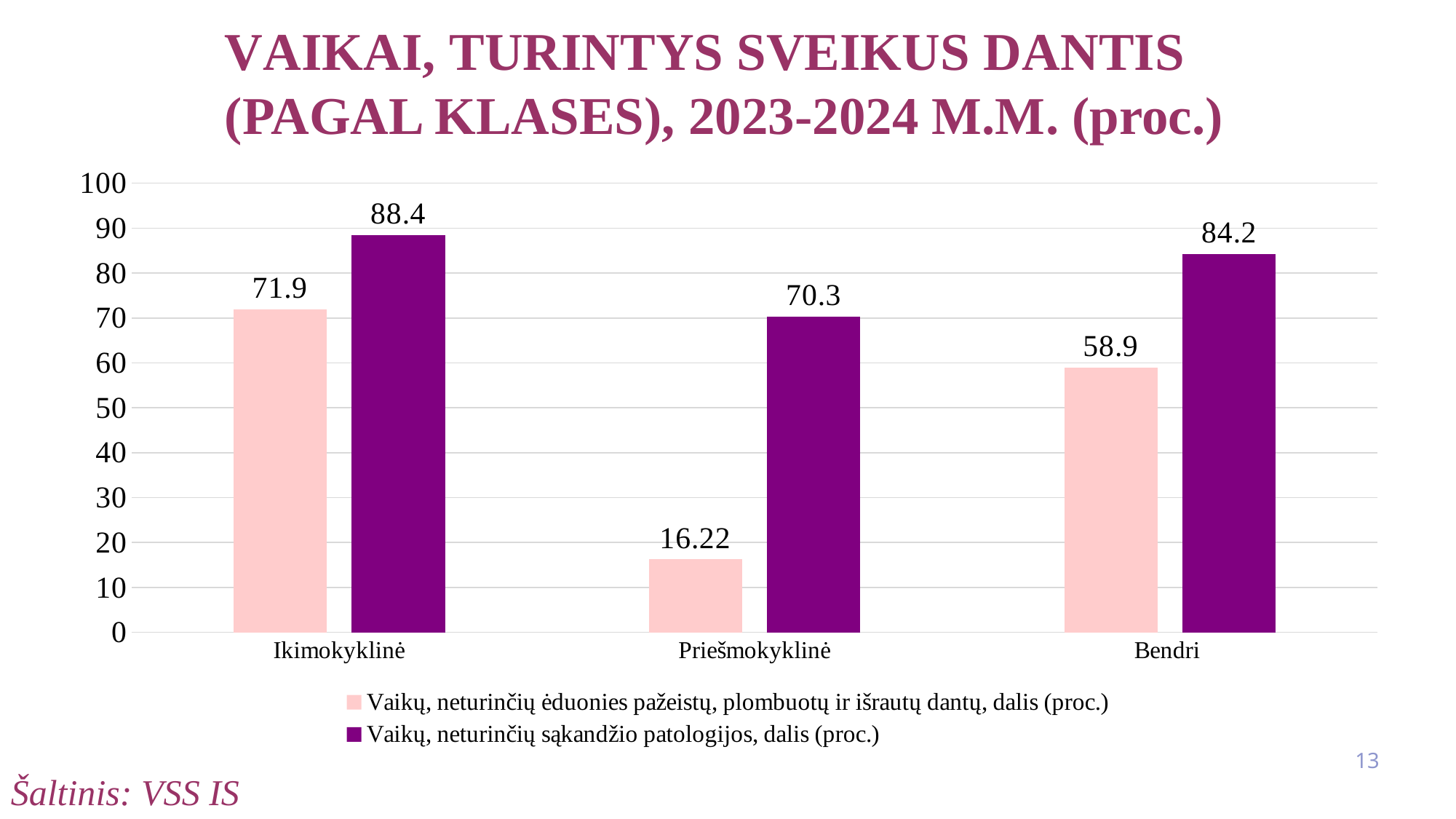
Which is larger for Bendri: the 'Vaikų, neturinčių ėduonies pažeistų, plombuotų ir išrautų dantų' value or the 'Vaikų, neturinčių sąkandžio patologijos' value? Vaikų, neturinčių sąkandžio patologijos, dalis (proc.) How many categories are shown on the x axis? 3 What is the value for Priešmokyklinė in the series 'Vaikų, neturinčių sąkandžio patologijos, dalis (proc.)'? 70.3 Is the value for Priešmokyklinė in the series 'Vaikų, neturinčių ėduonies pažeistų, plombuotų ir išrautų dantų, dalis (proc.)' greater or less than 20? less What is the value for Ikimokyklinė in the series 'Vaikų, neturinčių ėduonies pažeistų, plombuotų ir išrautų dantų, dalis (proc.)'? 71.9 How many series does the legend list? 2 What is the value for Bendri in the series 'Vaikų, neturinčių ėduonies pažeistų, plombuotų ir išrautų dantų, dalis (proc.)'? 58.9 What kind of chart is shown on the slide? bar chart What is the difference between the two series values for Priešmokyklinė? 54.08 What is the difference between the Ikimokyklinė and Bendri values in the series 'Vaikų, neturinčių sąkandžio patologijos, dalis (proc.)'? 4.2 Which category has the lowest value in the series 'Vaikų, neturinčių ėduonies pažeistų, plombuotų ir išrautų dantų, dalis (proc.)'? Priešmokyklinė Which category has the highest value in the series 'Vaikų, neturinčių sąkandžio patologijos, dalis (proc.)'? Ikimokyklinė